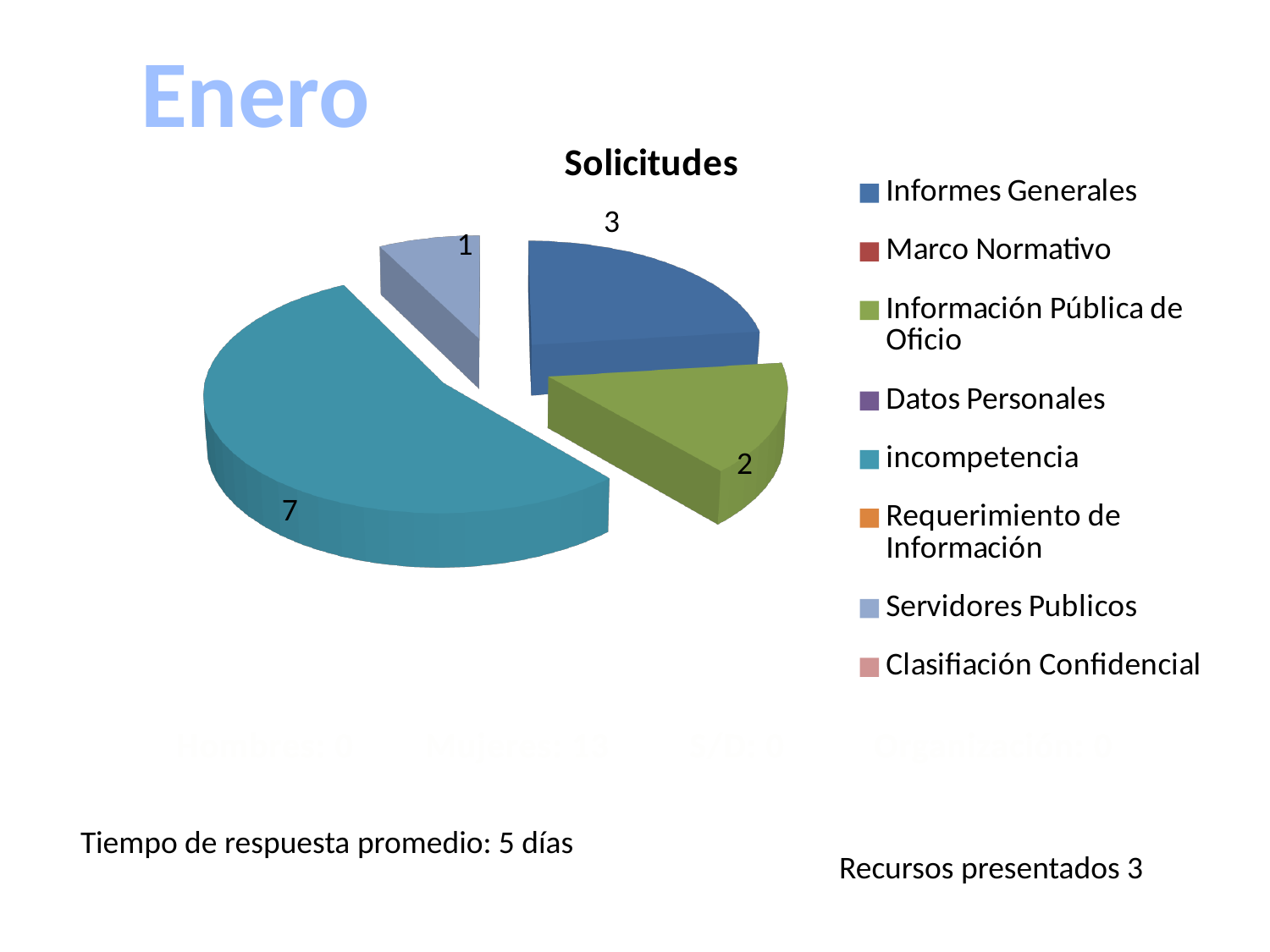
What is the value for Información Pública de Oficio in the Solicitudes pie chart? 2 Which is larger, Informes Generales or Información Pública de Oficio? Informes Generales How many entries does the legend list? 8 What is the total of the four labelled slices in the Solicitudes pie chart? 13 What is the value for incompetencia in the Solicitudes pie chart? 7 What kind of chart is shown on the slide? Pie chart What is the value for Informes Generales in the Solicitudes pie chart? 3 What is the value for Servidores Publicos in the Solicitudes pie chart? 1 Which labelled slice is the smallest in the Solicitudes pie chart? Servidores Publicos Which category has the largest slice in the Solicitudes pie chart? incompetencia What is the difference between the values for incompetencia and Informes Generales? 4 What is the title of the chart? Solicitudes